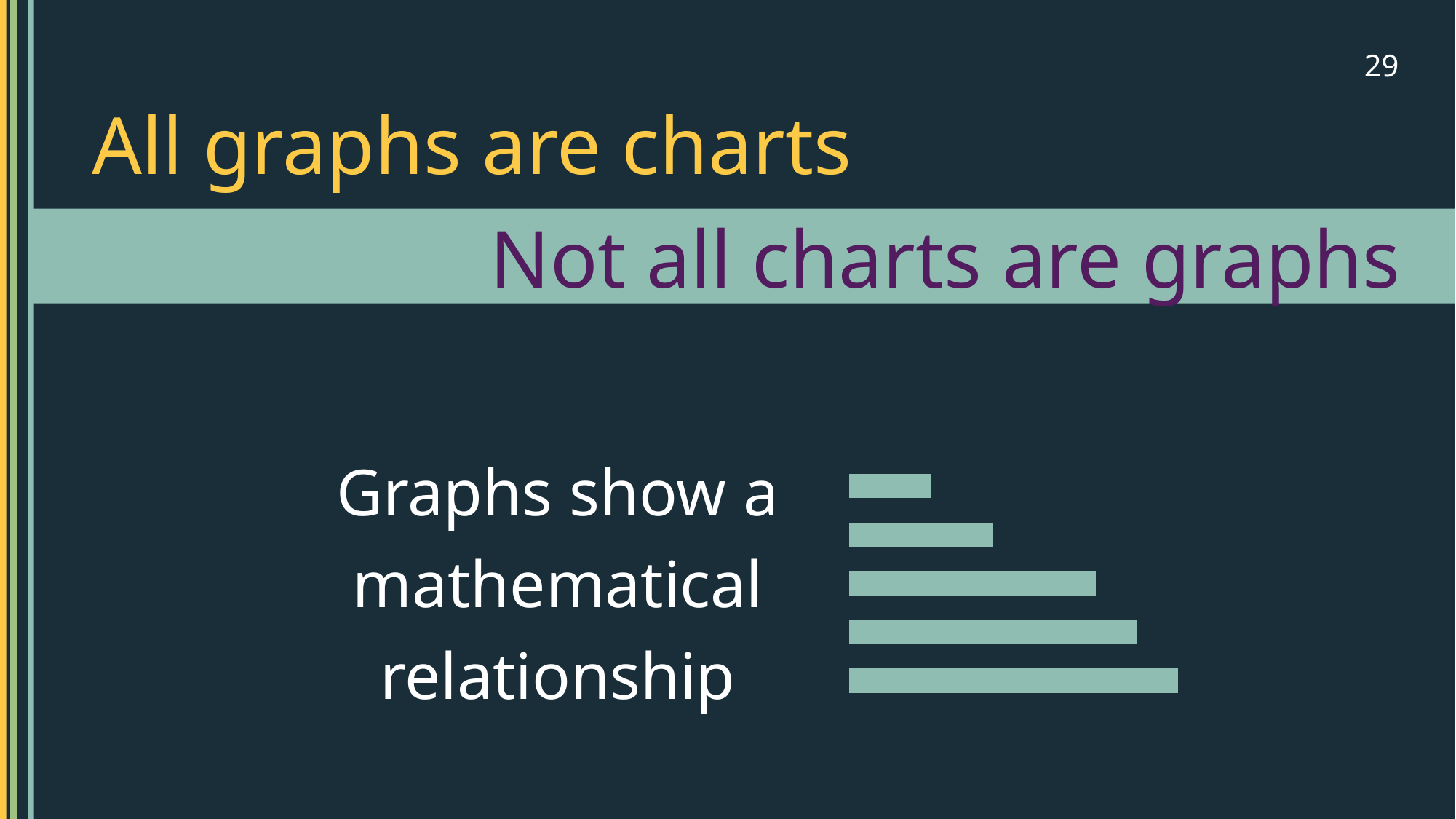
Which bar in the chart is the longest, the top one or the bottom one? the bottom one How many bars does the chart on the slide have? 5 Which bar in the chart is the shortest, the top one or the bottom one? the top one Do the bars get longer or shorter going from the top of the chart to the bottom? longer Are the bars in the chart horizontal or vertical? horizontal Is the second bar from the top longer or shorter than the fourth bar from the top? shorter Does the chart show any axis labels or data labels? No What kind of chart is shown on the slide? bar chart